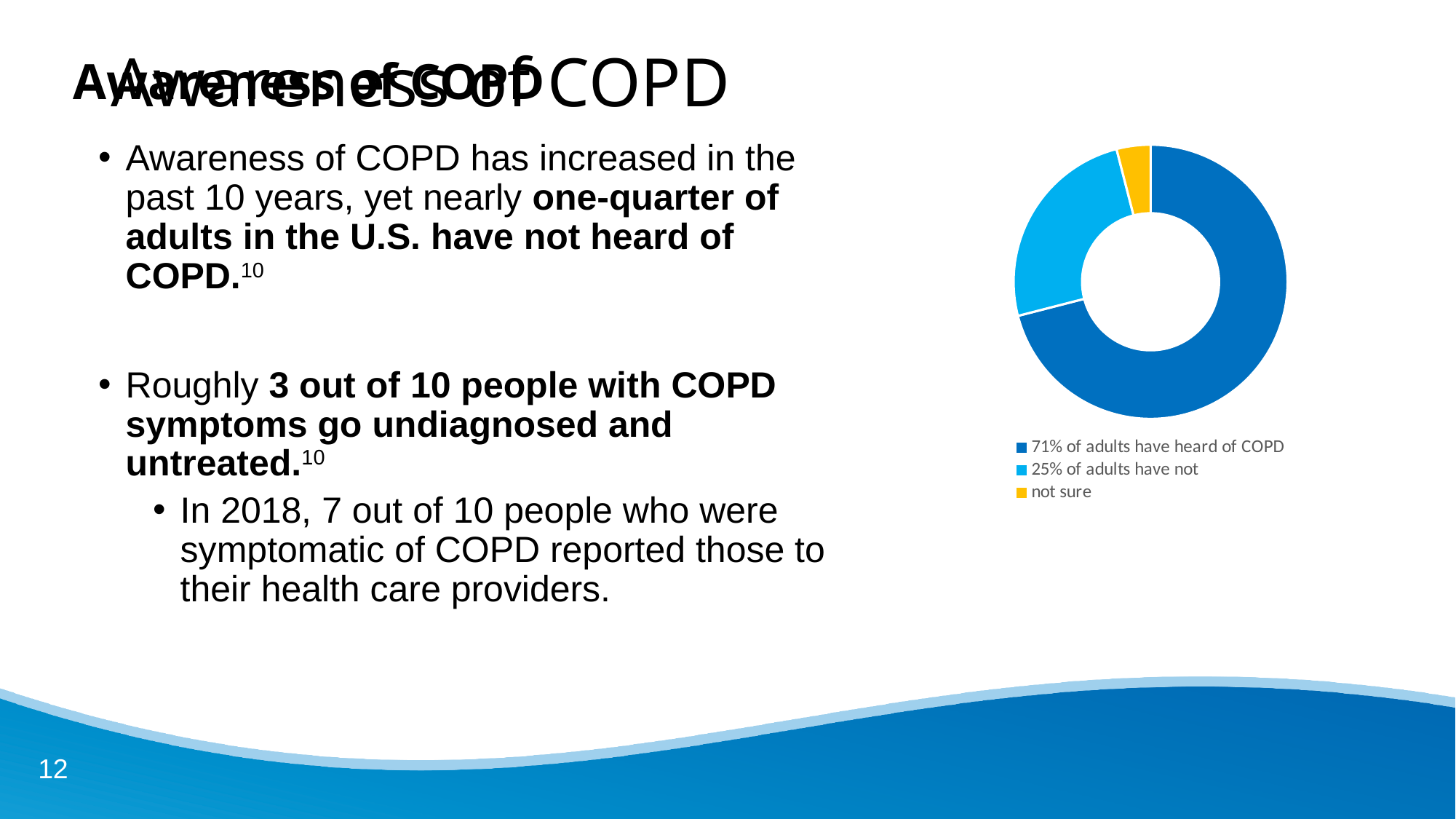
What is the difference in percentage points between adults who have heard of COPD and adults who have not? 46 Which slice of the doughnut chart is the smallest? not sure How many slices does the doughnut chart have? 3 According to the chart legend, what percentage of adults have heard of COPD? 71% Which slice of the doughnut chart is the largest? 71% of adults have heard of COPD What kind of chart is shown on the slide? doughnut chart What colour is the 'not sure' slice in the doughnut chart? yellow According to the chart legend, what percentage of adults have not heard of COPD? 25% What is the legend label of the dark blue slice? 71% of adults have heard of COPD Which is larger: the slice for adults who have not heard of COPD or the 'not sure' slice? 25% of adults have not Which is larger: the slice for adults who have heard of COPD or the slice for adults who have not? 71% of adults have heard of COPD How many entries does the chart legend list? 3